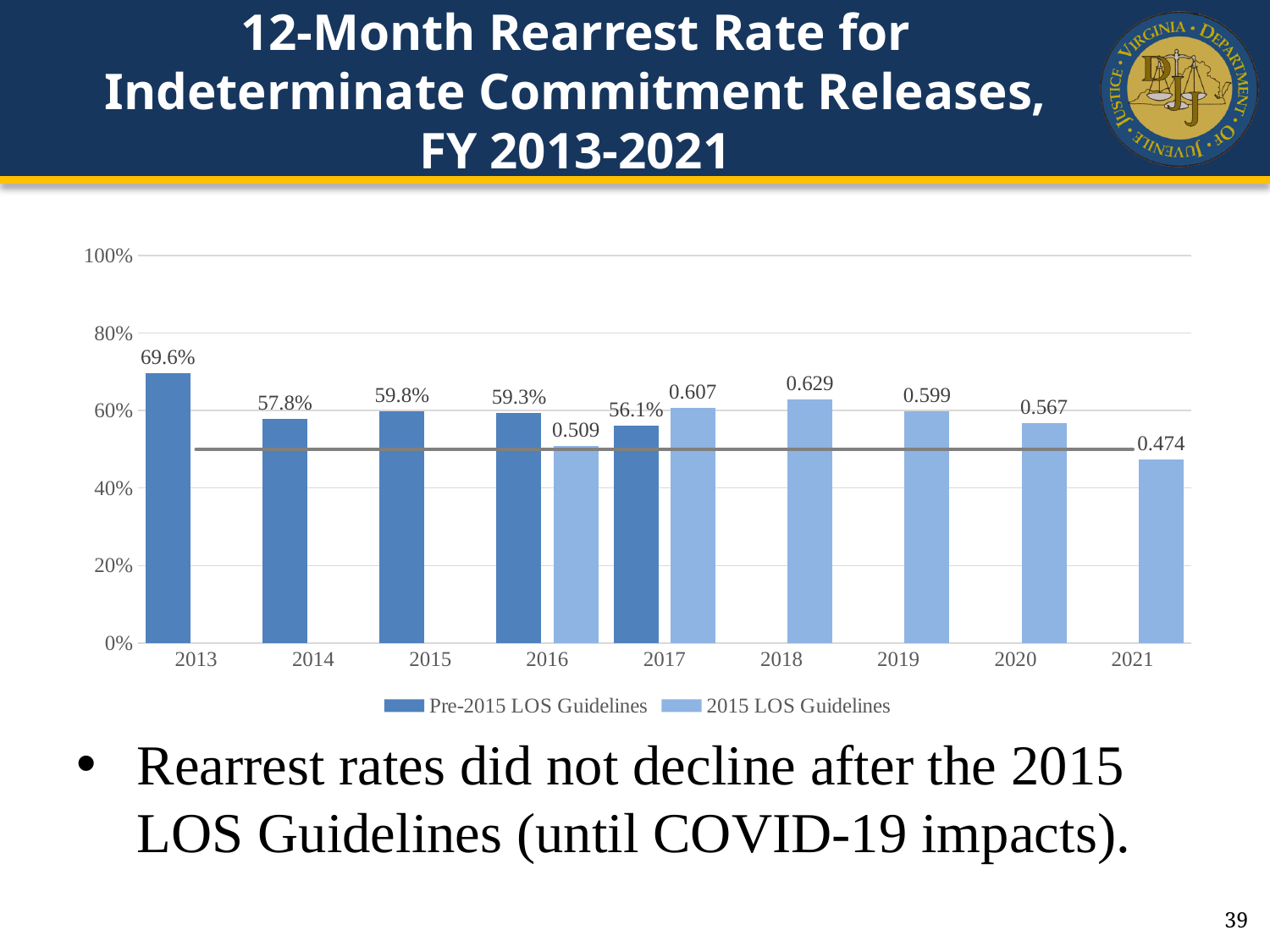
What is the value of the Pre-2015 LOS Guidelines bar for 2017? 56.1% What is the difference between the 2015 LOS Guidelines values for 2018 and 2021? 0.155 What is the value of the 2015 LOS Guidelines bar for 2018? 0.629 Do the 2015 LOS Guidelines values rise or fall from 2018 to 2021? fall What is the 12-month rearrest rate shown for 2013? 69.6% Which year has the highest rearrest rate on the chart? 2013 Which is larger, the 2015 LOS Guidelines value for 2019 or for 2020? 2019 What is the difference between the Pre-2015 LOS Guidelines values for 2013 and 2014? 11.8 percentage points How many series does the legend list? 2 What is the value of the 2015 LOS Guidelines bar for 2016? 0.509 How many years are shown on the x axis? 9 Which year has the lowest rearrest rate on the chart? 2021